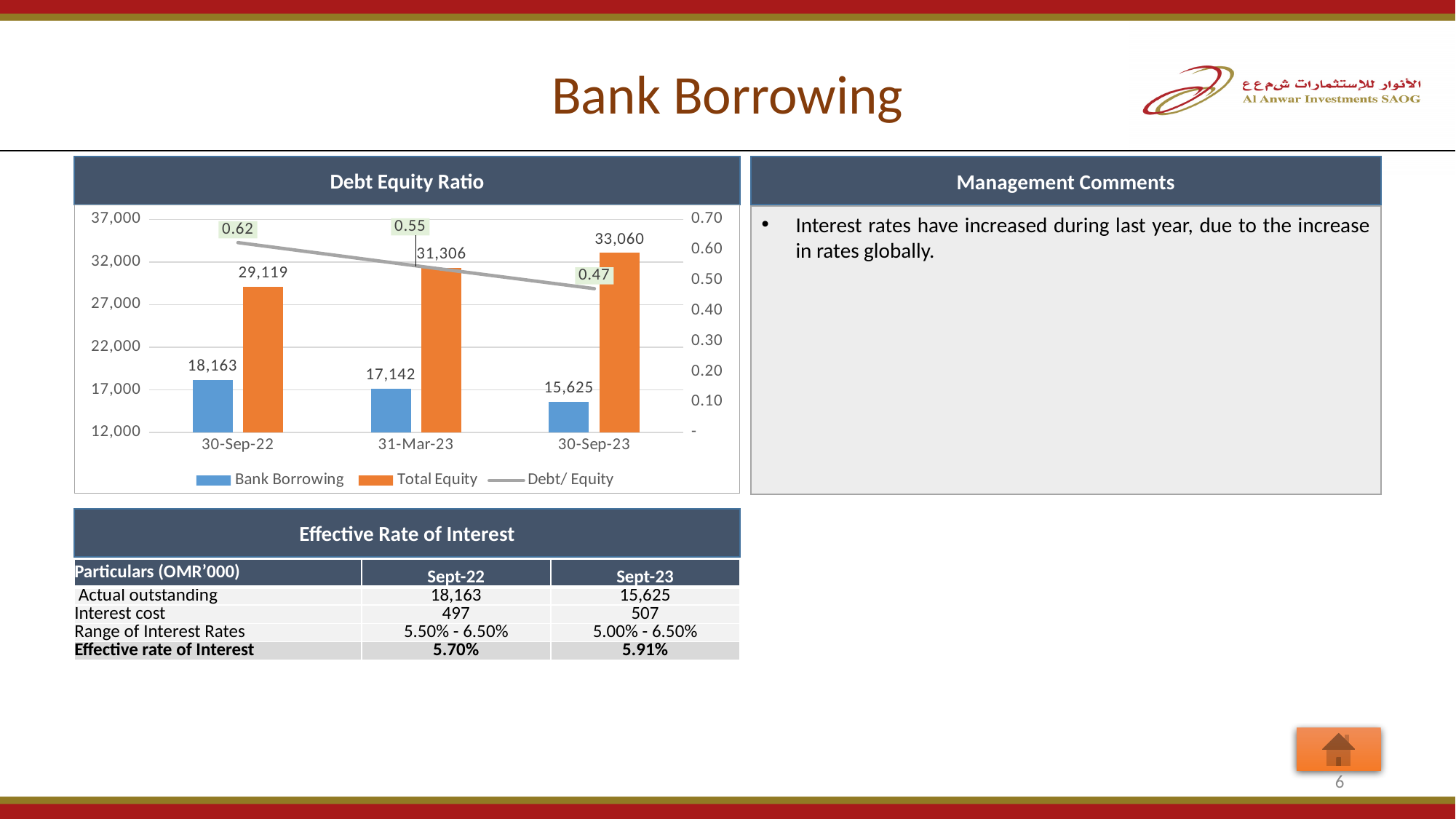
What colour are the Total Equity bars in the Debt Equity Ratio chart? Orange Which date has the highest Total Equity value? 30-Sep-23 What is the Debt/ Equity ratio for 31-Mar-23? 0.55 What is the difference between Total Equity and Bank Borrowing at 31-Mar-23? 14,164 Is Bank Borrowing at 30-Sep-22 or at 30-Sep-23 larger? 30-Sep-22 How many dates are shown on the x axis of the Debt Equity Ratio chart? 3 What kind of chart is the Debt Equity Ratio chart? Combined bar and line chart What is the Bank Borrowing value for 30-Sep-22? 18,163 How many series does the legend of the Debt Equity Ratio chart list? 3 Does the Debt/ Equity line rise or fall from 30-Sep-22 to 30-Sep-23? fall Which date has the lowest Bank Borrowing value? 30-Sep-23 What is the Total Equity value for 30-Sep-23? 33,060